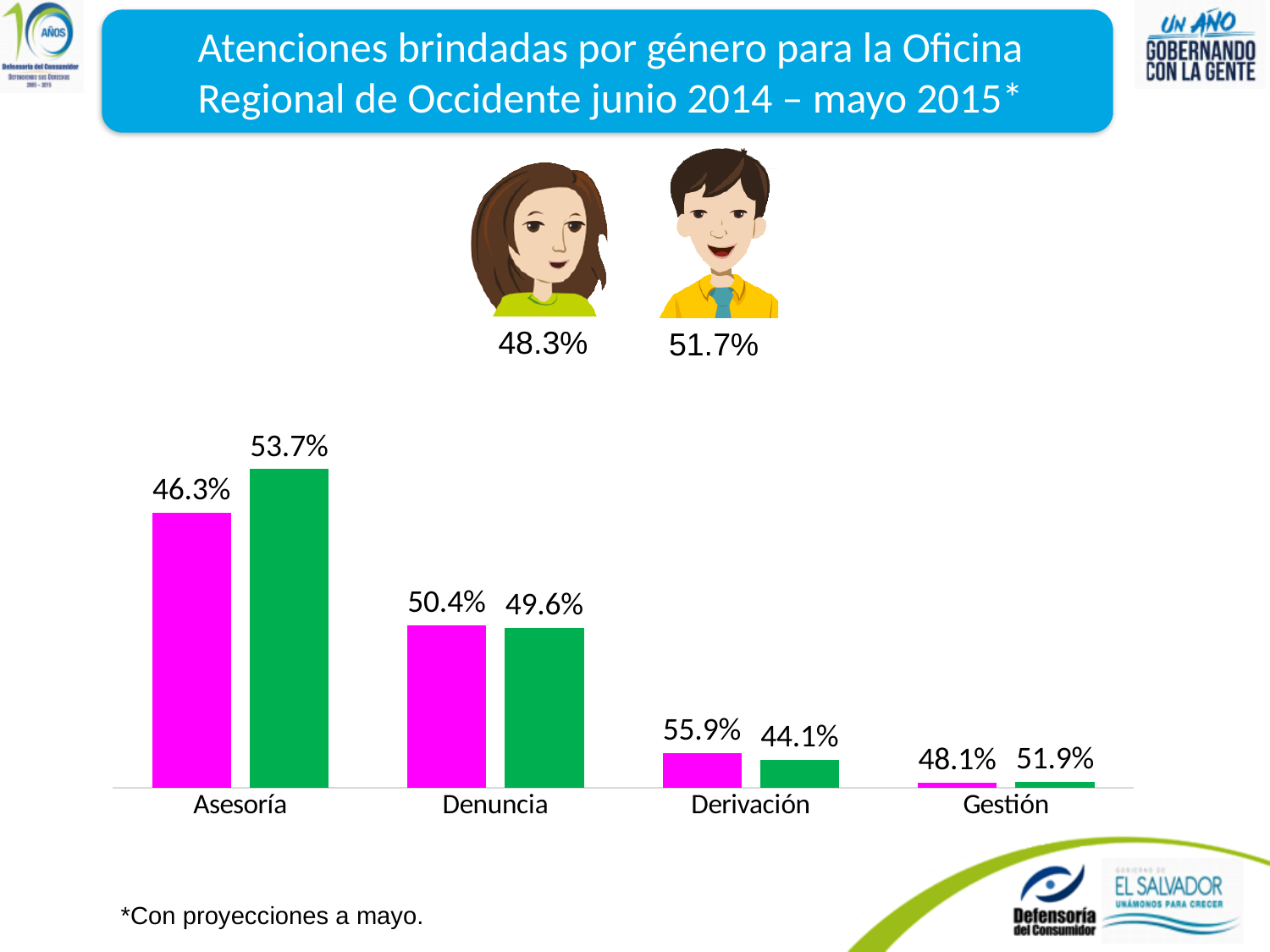
What is the value of the green bar for Derivación? 44.1% What kind of chart is shown on the slide? Bar chart What is the value of the magenta bar for Derivación? 55.9% What is the label of the last category on the x axis? Gestión What is the value of the green bar for Gestión? 51.9% What is the value of the green bar for Asesoría? 53.7% For Derivación, what is the difference between the magenta bar value and the green bar value? 11.8 percentage points What is the value of the magenta bar for Denuncia? 50.4% What is the value of the magenta bar for Asesoría? 46.3% For Asesoría, how much larger is the green bar value than the magenta bar value? 7.4 percentage points For Denuncia, which bar has the larger labelled value, the magenta bar or the green bar? The magenta bar How many categories are shown on the x axis of the chart? 4